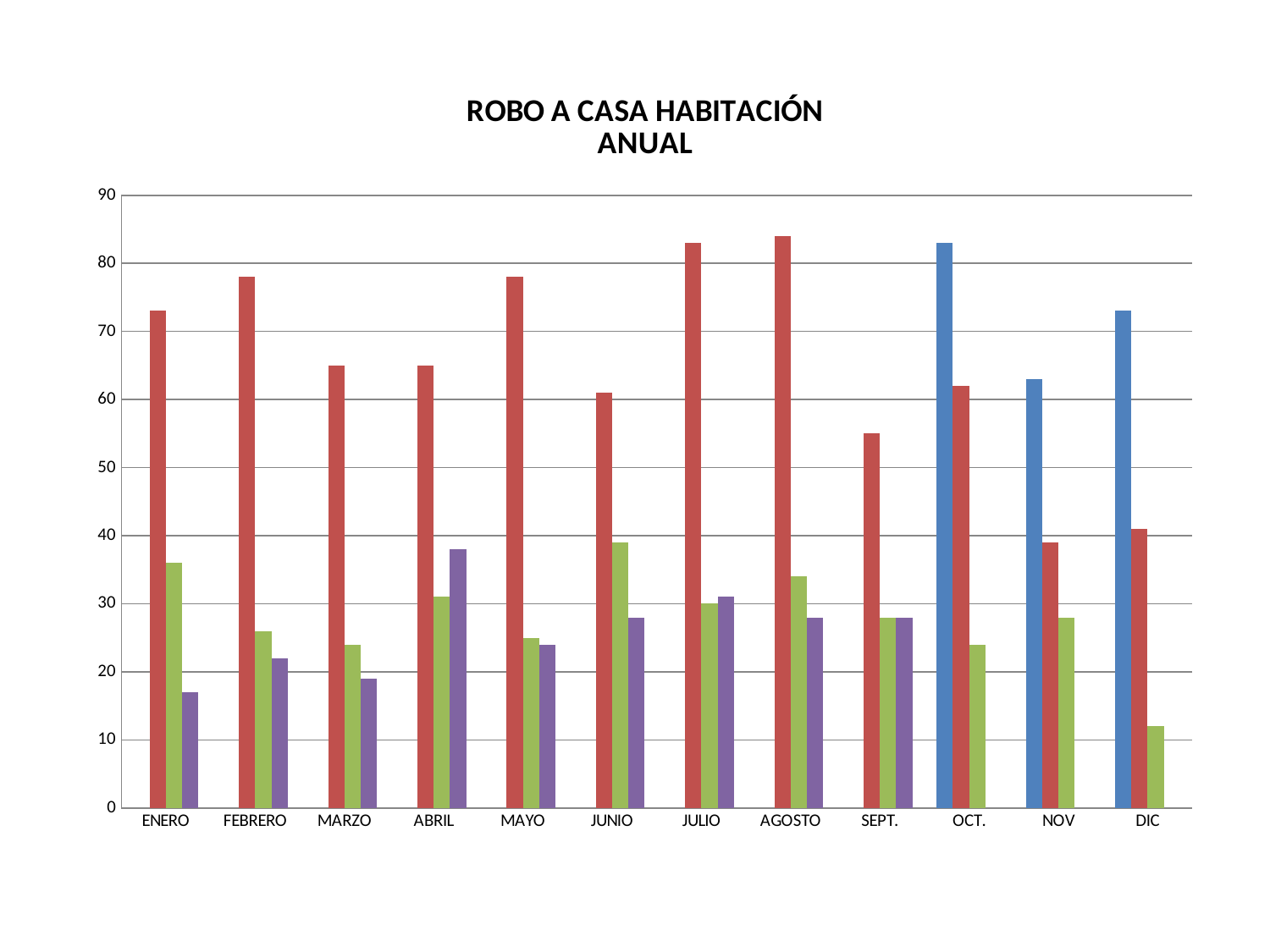
What is the title of the chart? ROBO A CASA HABITACIÓN ANUAL Is the red bar for SEPT. greater or less than 60? less Is the blue bar for OCT. greater or less than 80? greater Is the green bar for DIC greater or less than 20? less Which is larger, the red bar for ENERO or the red bar for MARZO? ENERO In which months does a blue bar appear? OCT., NOV, DIC Which month has the tallest purple bar? ABRIL How many months are shown along the x axis of the chart? 12 What kind of chart is shown on the slide? bar chart Which month has the lowest green bar? DIC